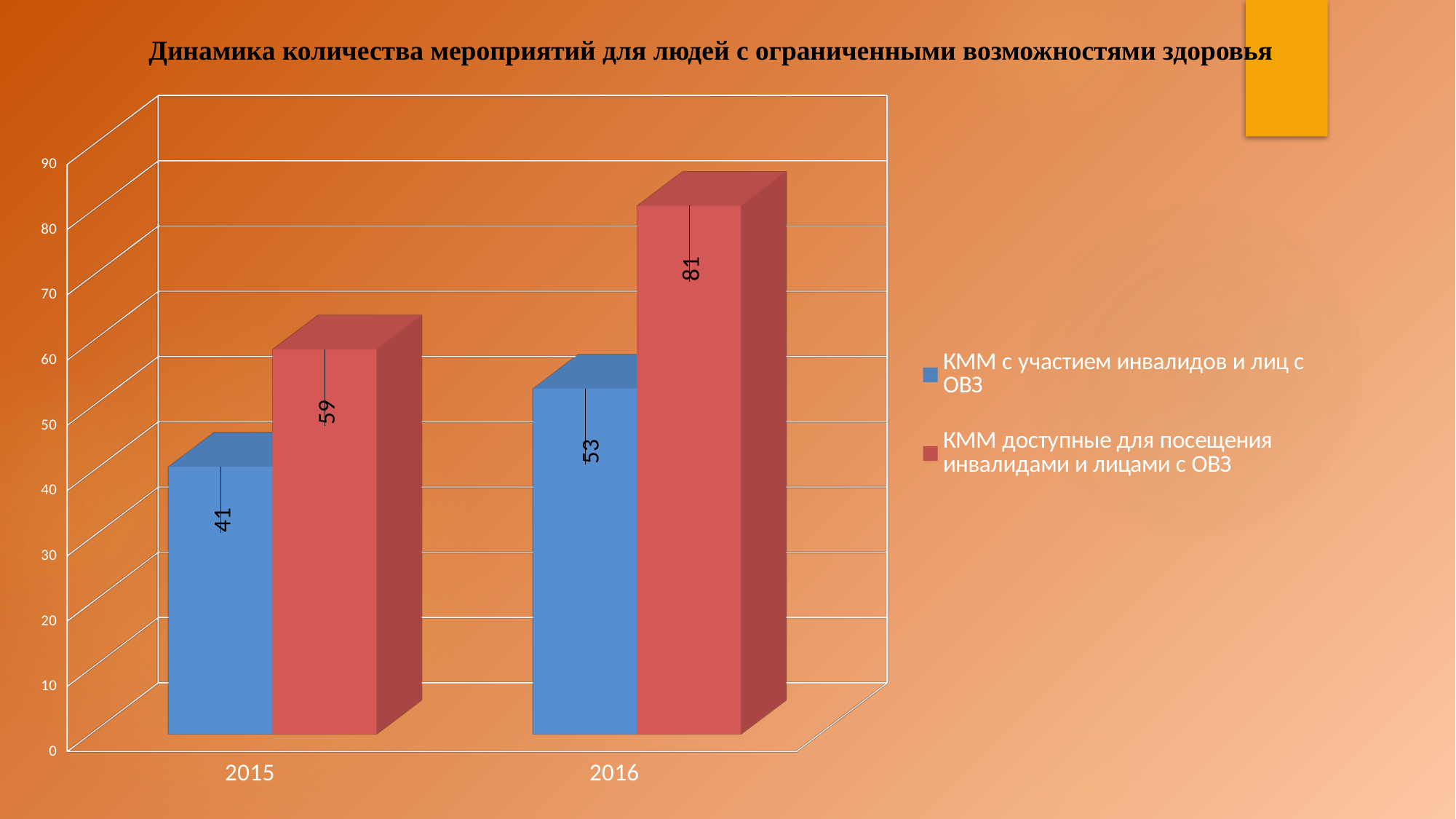
What is the difference between the 2016 and 2015 values for 'КММ с участием инвалидов и лиц с ОВЗ'? 12 In 2015, which series has the larger value: 'КММ с участием инвалидов и лиц с ОВЗ' or 'КММ доступные для посещения инвалидами и лицами с ОВЗ'? КММ доступные для посещения инвалидами и лицами с ОВЗ What is the value for 'КММ доступные для посещения инвалидами и лицами с ОВЗ' in 2015? 59 Which bar has the lowest value on the chart? КММ с участием инвалидов и лиц с ОВЗ in 2015 Which year has the highest value for 'КММ доступные для посещения инвалидами и лицами с ОВЗ'? 2016 How many series does the legend list? 2 What is the difference between the 2016 and 2015 values for 'КММ доступные для посещения инвалидами и лицами с ОВЗ'? 22 How many years are shown on the x axis? 2 What kind of chart is shown on the slide? Bar chart What is the value for 'КММ с участием инвалидов и лиц с ОВЗ' in 2015? 41 What is the value for 'КММ с участием инвалидов и лиц с ОВЗ' in 2016? 53 What is the value for 'КММ доступные для посещения инвалидами и лицами с ОВЗ' in 2016? 81